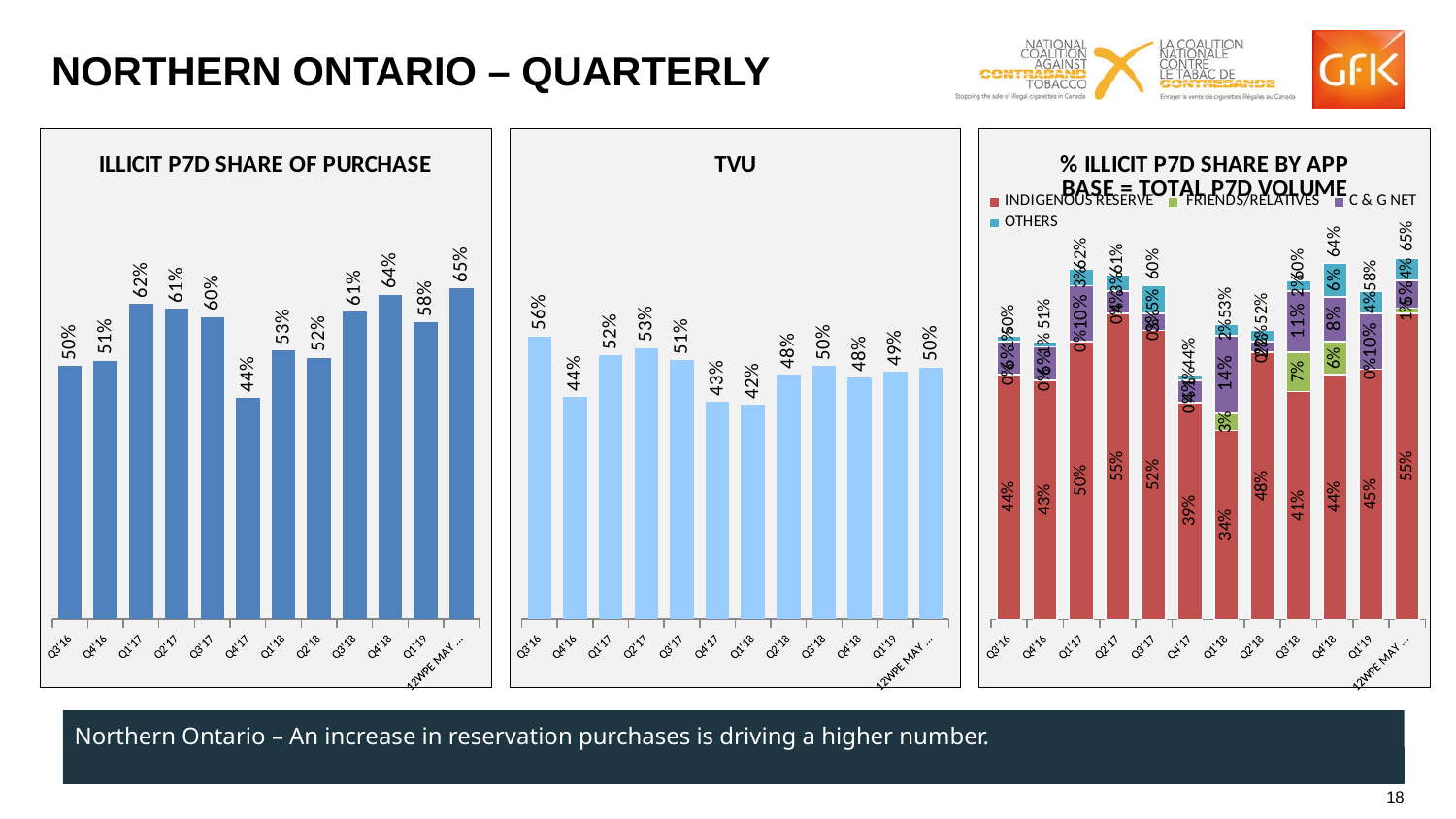
In the TVU chart, what is the value for Q3'16? 56% In the TVU chart, what is the difference between the Q3'16 value and the Q4'16 value? 12% In the % ILLICIT P7D SHARE BY APP chart, what is the INDIGENOUS RESERVE value for Q1'18? 34% In the TVU chart, which is larger, the value for Q2'17 or the value for Q4'17? Q2'17 In the ILLICIT P7D SHARE OF PURCHASE chart, how many bars are plotted? 12 In the % ILLICIT P7D SHARE BY APP chart, which series is shown in red? INDIGENOUS RESERVE What kind of chart is the TVU chart? Bar chart In the ILLICIT P7D SHARE OF PURCHASE chart, what is the value for Q1'17? 62% In the ILLICIT P7D SHARE OF PURCHASE chart, which quarter has the lowest value? Q4'17 In the TVU chart, which period has the lowest value? Q1'18 In the ILLICIT P7D SHARE OF PURCHASE chart, what is the difference between the Q4'18 value and the Q1'19 value? 6% In the % ILLICIT P7D SHARE BY APP chart, how many series does the legend list? 4